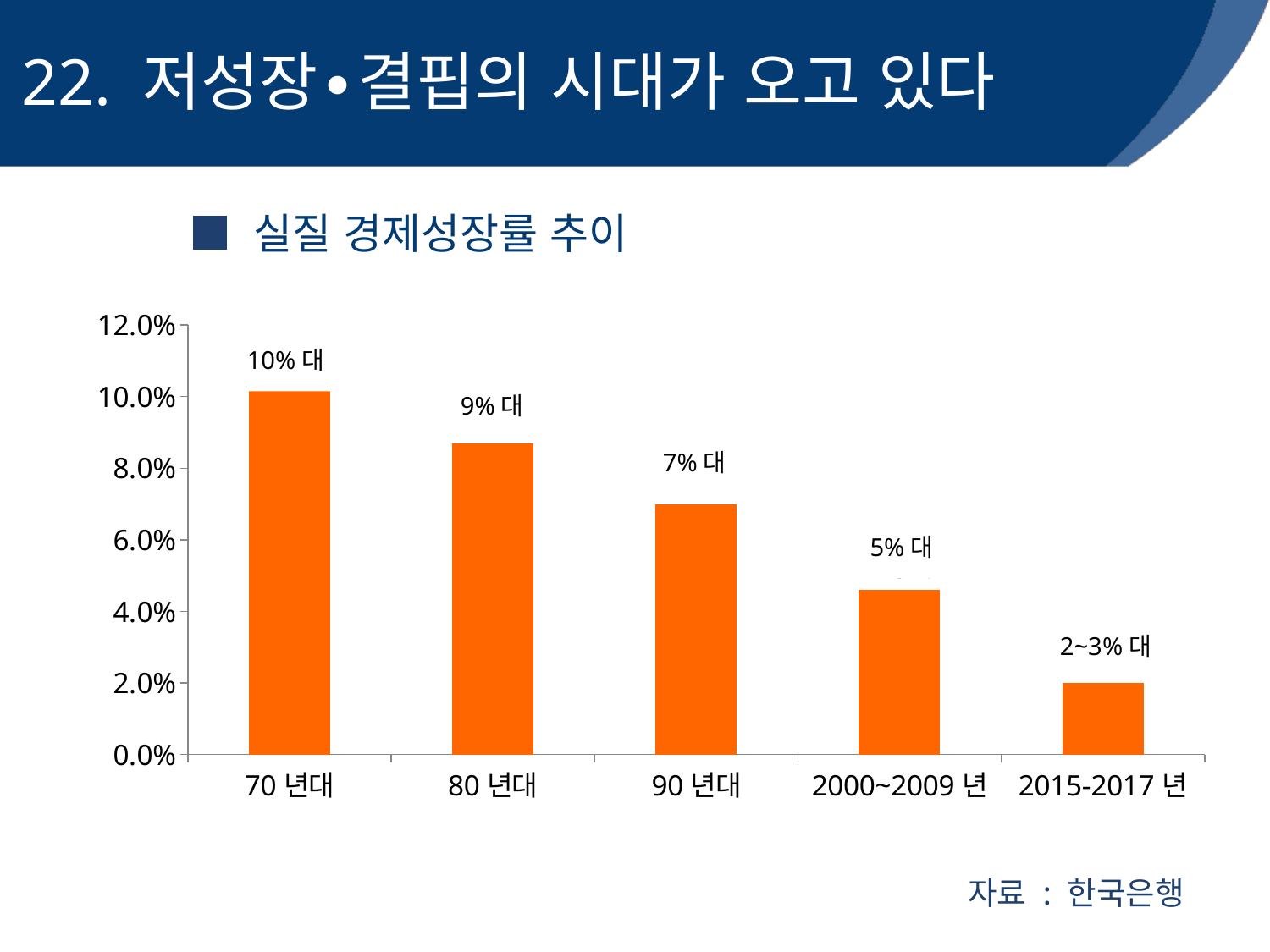
What is the data label shown for 70 년대? 10% 대 What kind of chart is shown on the slide? bar chart Is the value for 2000~2009 년 greater or less than 6.0%? less What is the title of the chart? 실질 경제성장률 추이 How many categories are shown on the x axis of the chart? 5 Do the values rise or fall from left to right along the x axis? fall Which category has the highest bar? 70 년대 What is the data label shown for 80 년대? 9% 대 What is the data label shown for 2000~2009 년? 5% 대 What is the data label shown for 90 년대? 7% 대 What is the data label shown for 2015-2017 년? 2~3% 대 Which category has the lowest bar? 2015-2017 년